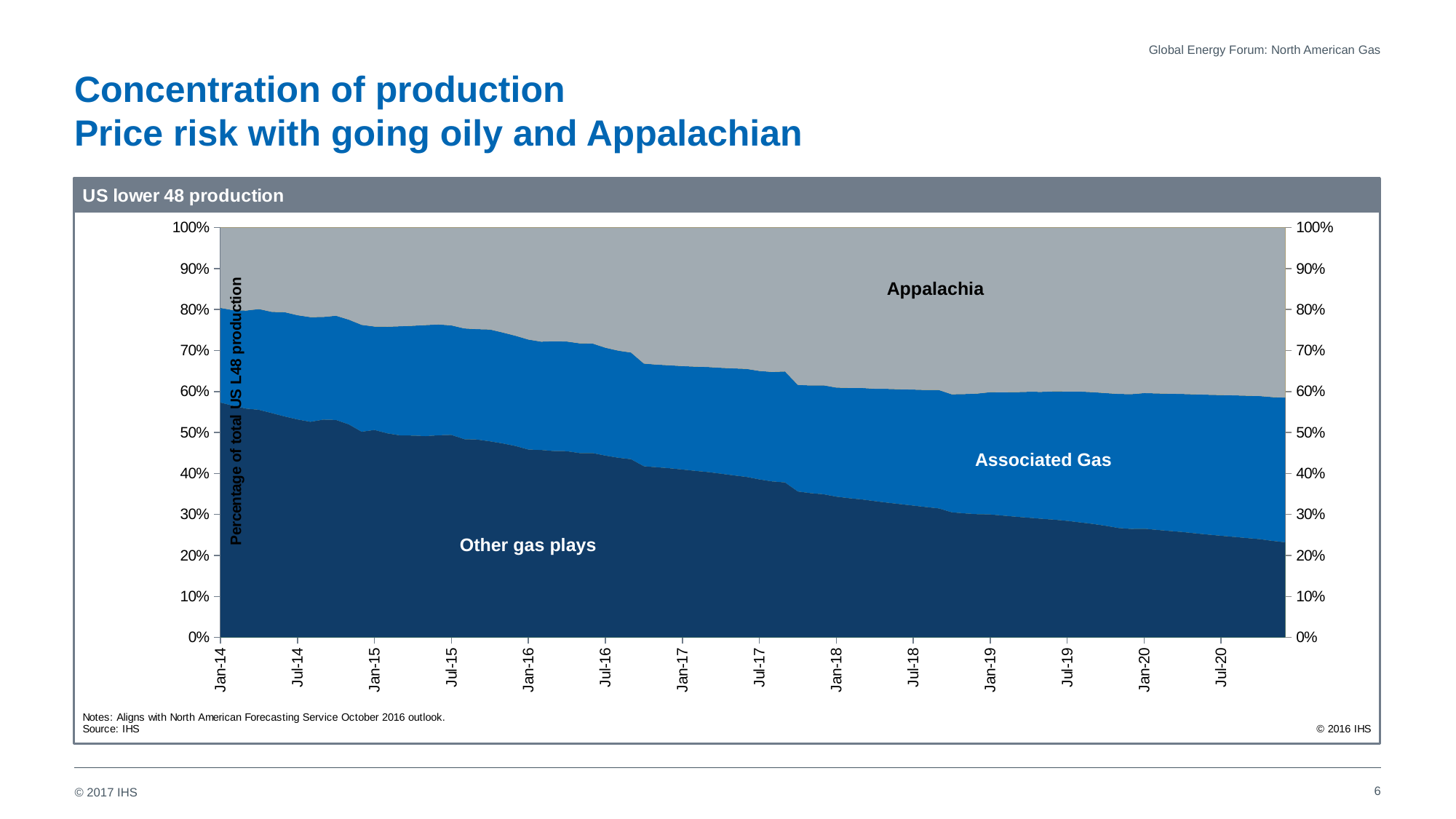
Does the share of Appalachia rise or fall from Jan-14 to Jul-20? Rise What kind of chart is shown on the slide? Stacked area chart How many date labels are shown on the x axis? 14 Is the share of Other gas plays at Jan-14 greater or less than 50%? greater Which series has the largest share of production at Jan-14? Other gas plays Does the share of Other gas plays rise or fall from Jan-14 to Jul-20? Fall What is the title of the chart? US lower 48 production How many series are plotted in the chart? 3 Is the share of Other gas plays at the end of the chart (late 2020) greater or less than 30%? less What is the label on the vertical axis of the chart? Percentage of total US L48 production At Jan-14, which is larger: the share of Other gas plays or the share of Appalachia? Other gas plays Which series has the smallest share of production at the end of the chart (late 2020)? Other gas plays